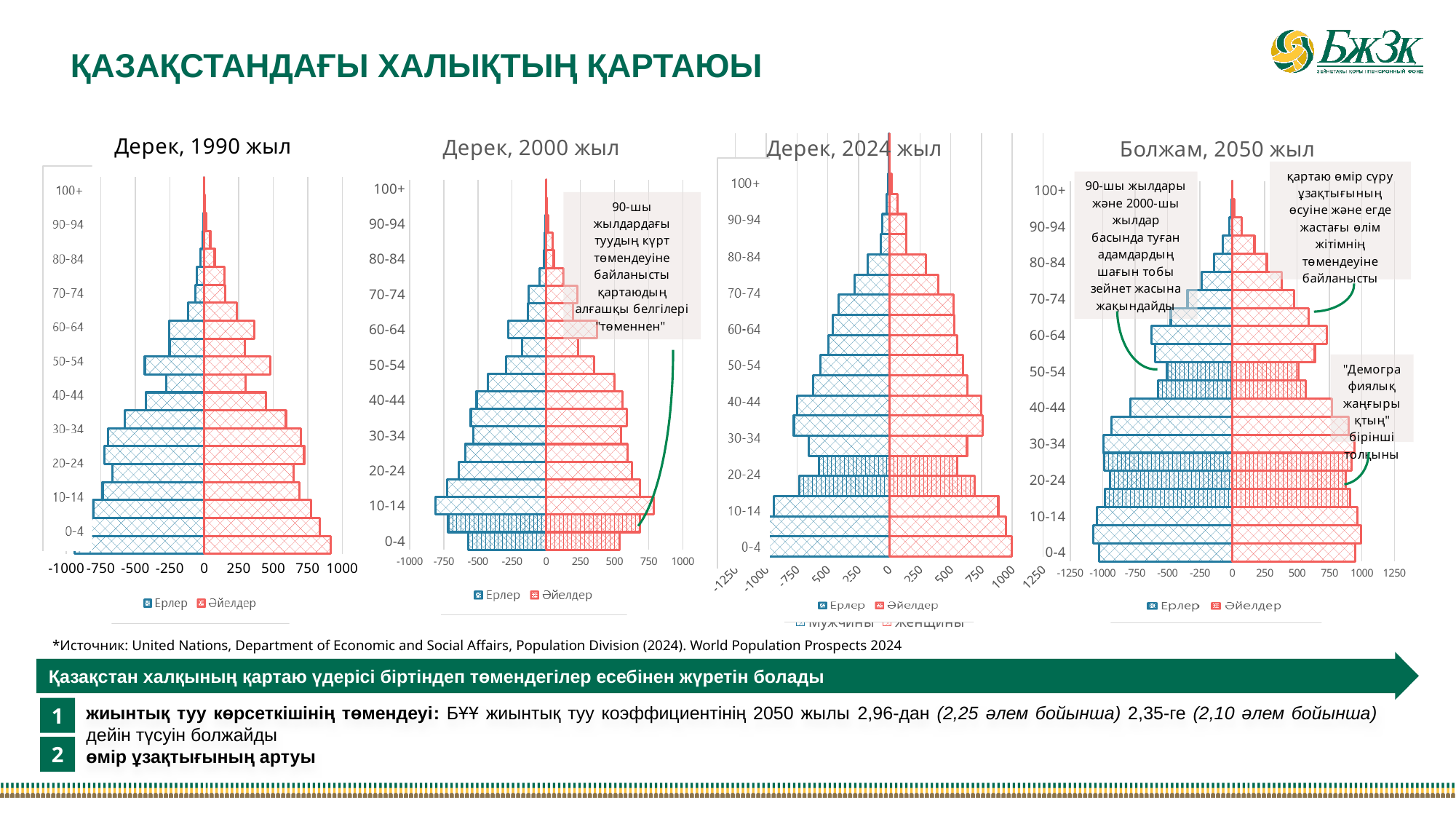
In the "Дерек, 2000 жыл" chart, is the Әйелдер value for the 10-14 age group greater or less than 500? greater In the "Дерек, 1990 жыл" chart, do the Әйелдер bars generally get longer or shorter as the age group increases from 0-4 to 100+? shorter What is the title of the rightmost chart on the slide? Болжам, 2050 жыл In the "Болжам, 2050 жыл" chart, is the Әйелдер value for the 100+ age group greater or less than 250? less In the "Дерек, 1990 жыл" chart, which age group has the longest Әйелдер bar? 0-4 In the "Дерек, 1990 жыл" chart, is the Әйелдер value for the 0-4 age group greater or less than 750? greater How many charts are shown on the slide? 4 In the "Дерек, 1990 жыл" chart, which is larger for Әйелдер: the 0-4 age group or the 60-64 age group? 0-4 What are the two legend entries of the "Болжам, 2050 жыл" chart? Ерлер and Әйелдер What kind of chart is the "Дерек, 1990 жыл" chart? Bar chart How many series does the legend of the "Дерек, 2000 жыл" chart list? 2